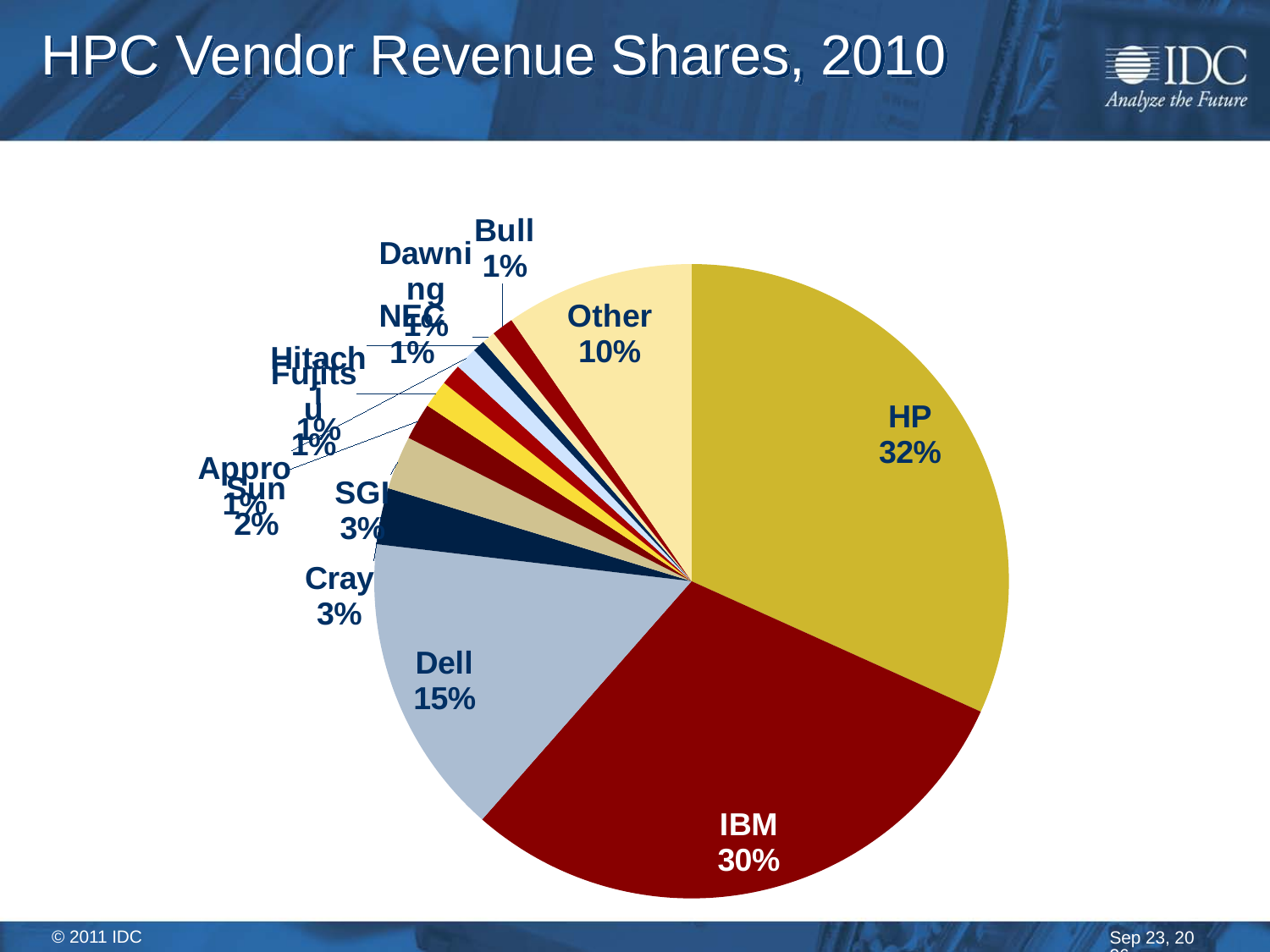
What is Cray's revenue share? 3% By how many percentage points does HP's share exceed IBM's? 2% What share of revenue does Dell hold? 15% What is the title of the chart? HPC Vendor Revenue Shares, 2010 Which has the larger share, HP or IBM? HP What is Bull's revenue share? 1% What is the difference between Dell's share and Cray's share? 12% What share is labelled for the 'Other' slice? 10% What is IBM's share of HPC vendor revenue in 2010? 30% What is HP's share of HPC vendor revenue in 2010? 32% What kind of chart is shown on the slide? pie chart Which vendor has the largest revenue share? HP